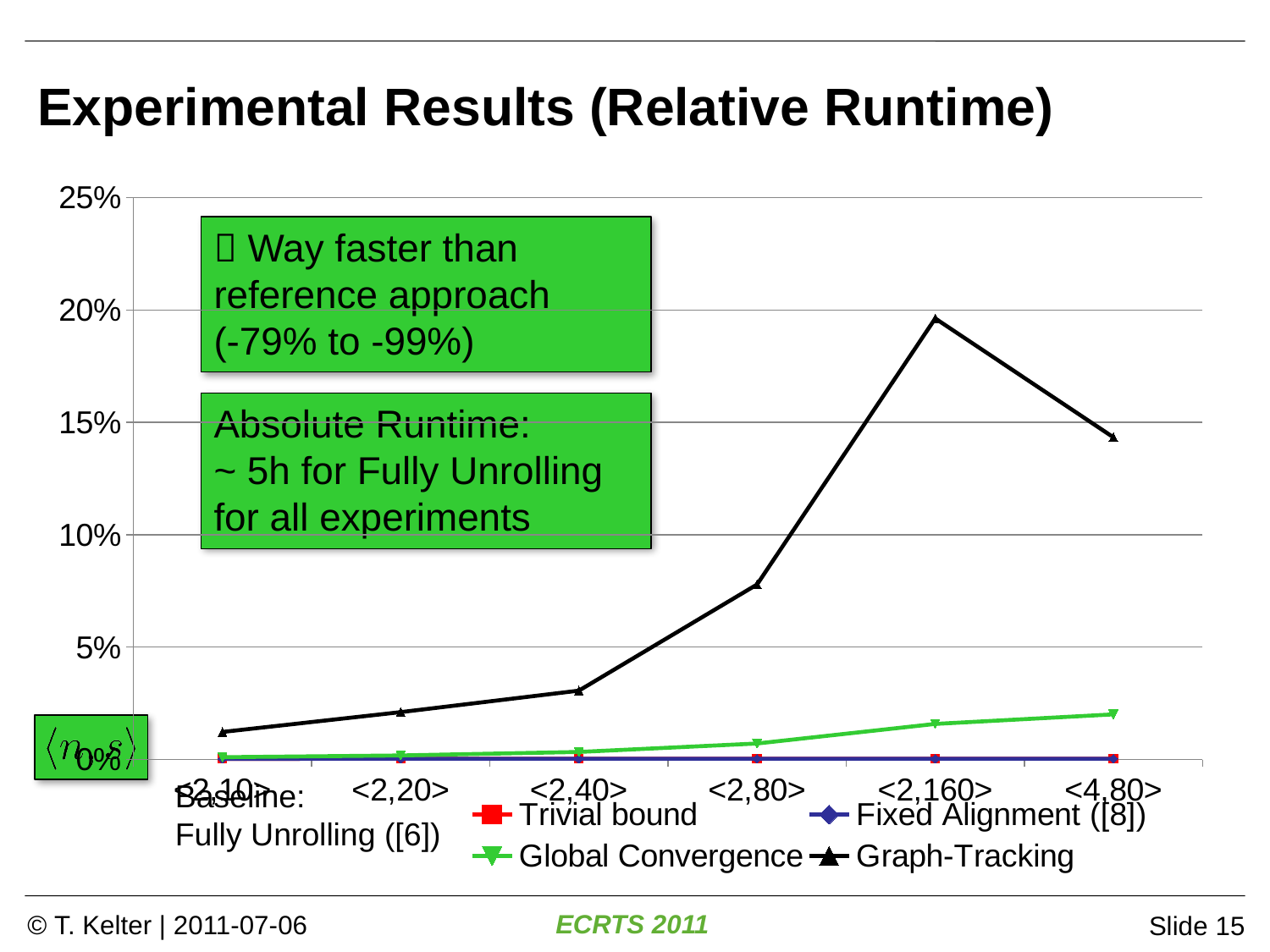
What kind of chart is shown on the slide? line chart What is the title of the slide containing the chart? Experimental Results (Relative Runtime) How many categories are shown on the x axis? 6 Is the value for Graph-Tracking at <2,160> greater or less than 15%? greater Does the Graph-Tracking series rise or fall from <2,10> to <2,160>? rise Is the value for Graph-Tracking at <4,80> greater or less than 10%? greater Is the value for Graph-Tracking at <2,80> greater or less than 5%? greater At which category does the Graph-Tracking series reach its highest value? <2,160> At <2,80>, which series has the larger value: Graph-Tracking or Global Convergence? Graph-Tracking Which is larger for Graph-Tracking: the value at <2,160> or the value at <4,80>? <2,160> At which category is the Graph-Tracking series lowest? <2,10> How many series does the legend list? 4